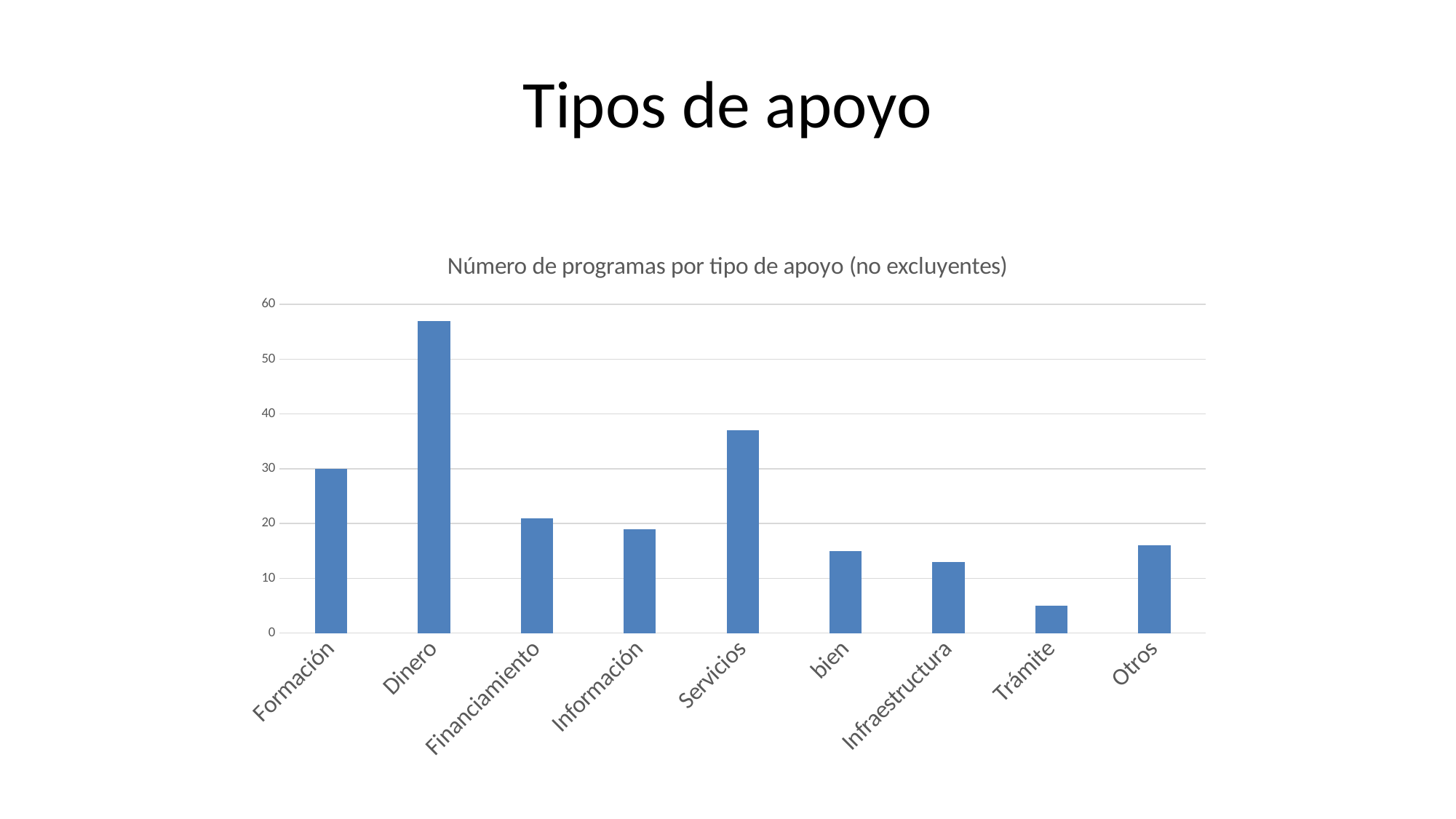
Is the value for Dinero greater or less than 50? greater Is the value for Trámite greater or less than 10? less What is the title of the chart? Número de programas por tipo de apoyo (no excluyentes) Which has more programs, Servicios or Formación? Servicios Is the value for Servicios greater or less than 40? less How many categories (types of support) are shown on the x axis? 9 What type of chart is shown on the slide? bar chart Which type of support has the highest number of programs? Dinero Which has more programs, Dinero or Servicios? Dinero What is the value for Formación? 30 Which type of support has the lowest number of programs? Trámite